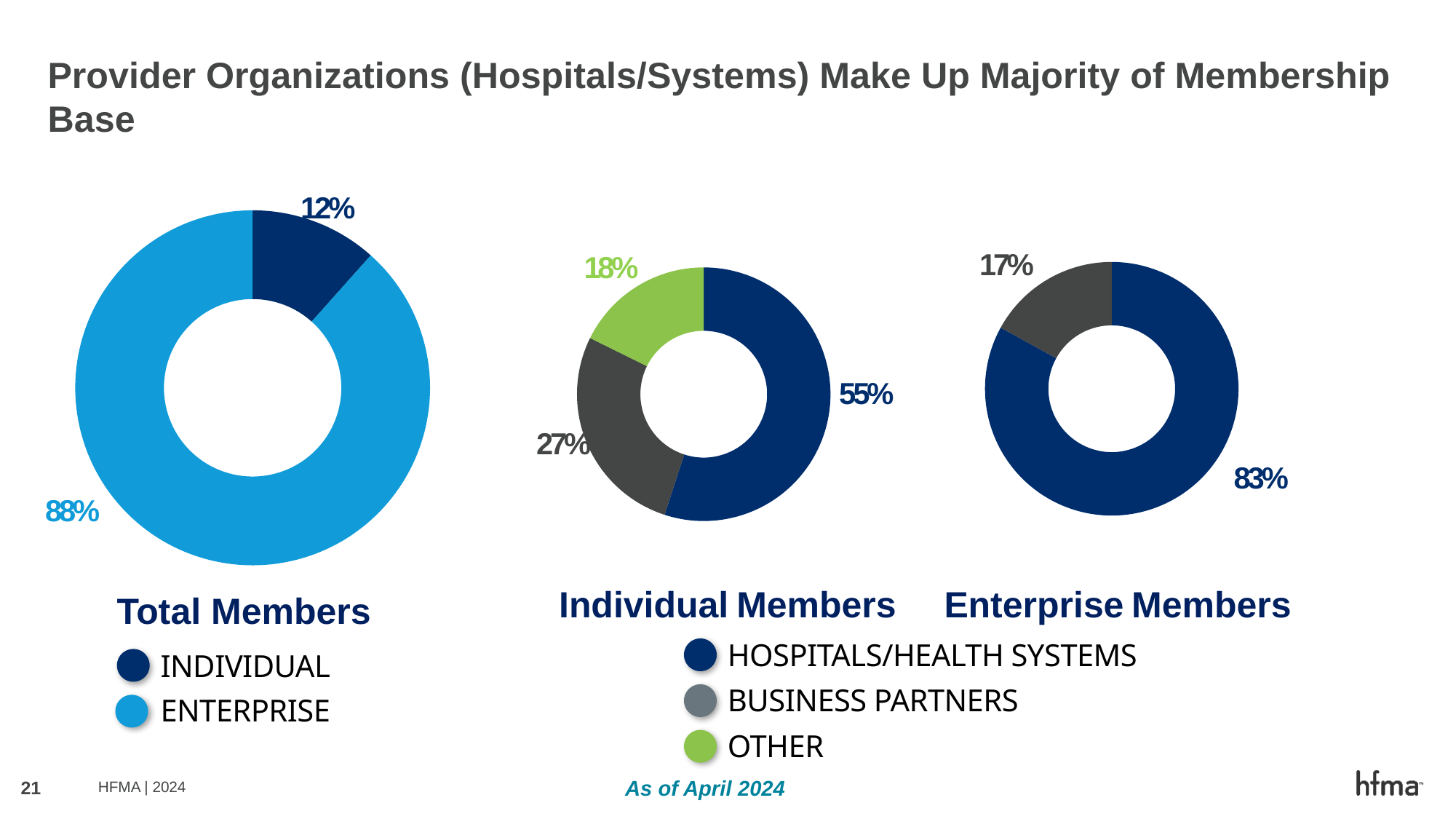
Which is larger: the Hospitals/Health Systems share in the Enterprise Members chart or in the Individual Members chart? Enterprise Members In the Individual Members chart, what is the difference between the Hospitals/Health Systems share and the Business Partners share? 28% In the Individual Members chart, what share is Other? 18% In the Total Members chart, what share of members is Enterprise? 88% In the Enterprise Members chart, what share is Business Partners? 17% What kind of chart is the Total Members chart? Doughnut chart In the Individual Members chart, what share is Business Partners? 27% In the Individual Members chart, which category has the smallest share? Other In the Enterprise Members chart, what share is Hospitals/Health Systems? 83% In the Individual Members chart, what share is Hospitals/Health Systems? 55% How many categories does the Individual Members chart show? 3 In the Total Members chart, what share of members is Individual? 12%